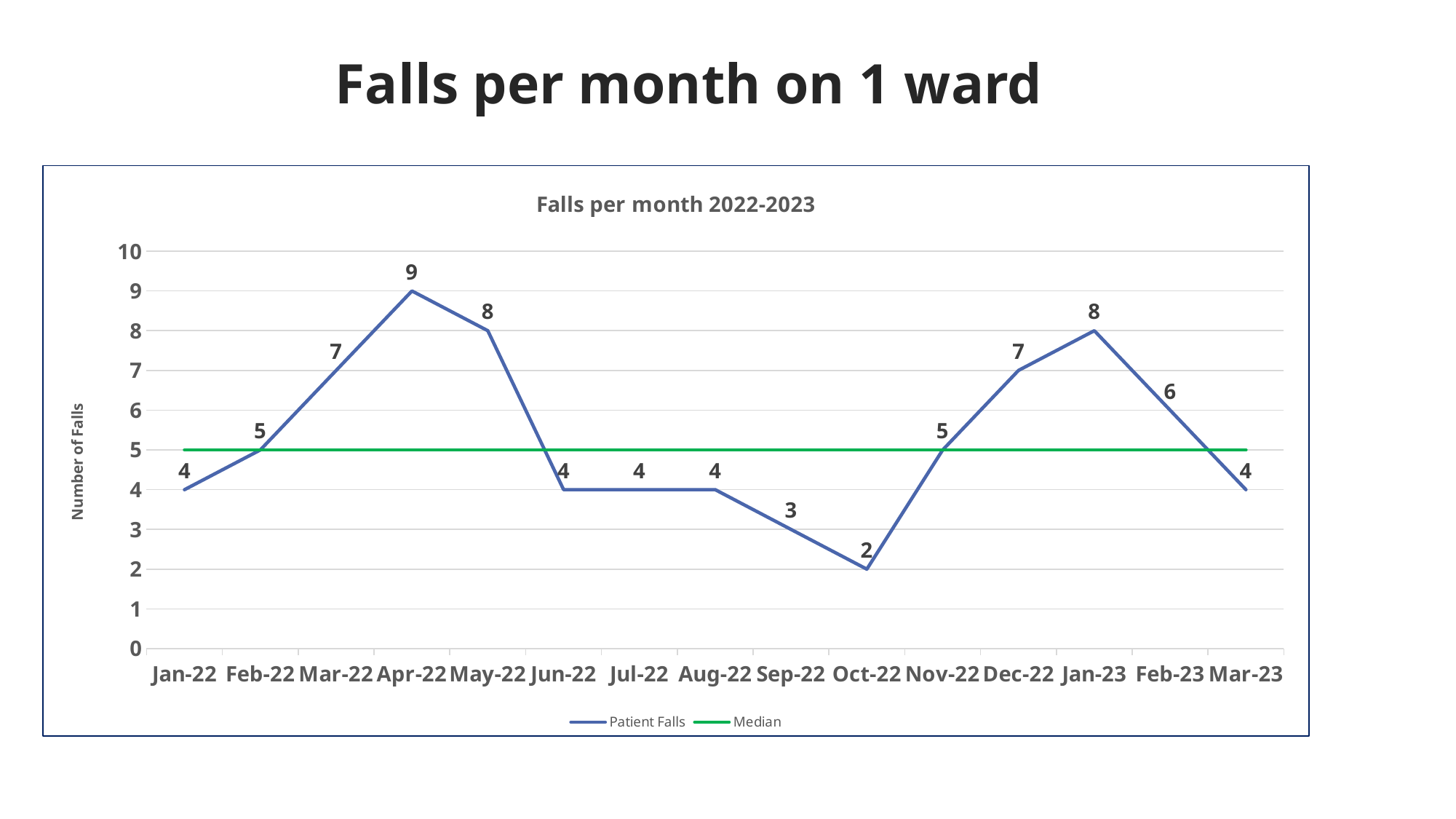
What is the value for Patient Falls in Apr-22? 9 What is the value for Patient Falls in Oct-22? 2 Which month has the lowest number of Patient Falls? Oct-22 Is the value for Patient Falls in Sep-22 greater or less than 5? less How many months are plotted on the x axis? 15 What kind of chart is shown? line chart Which is larger, Patient Falls in May-22 or Dec-22? May-22 Which month has the highest number of Patient Falls? Apr-22 What is the value for Patient Falls in Jan-23? 8 How many series does the legend list? 2 What is the difference between Patient Falls in Apr-22 and Oct-22? 7 What is the title of the chart inside the plot area? Falls per month 2022-2023